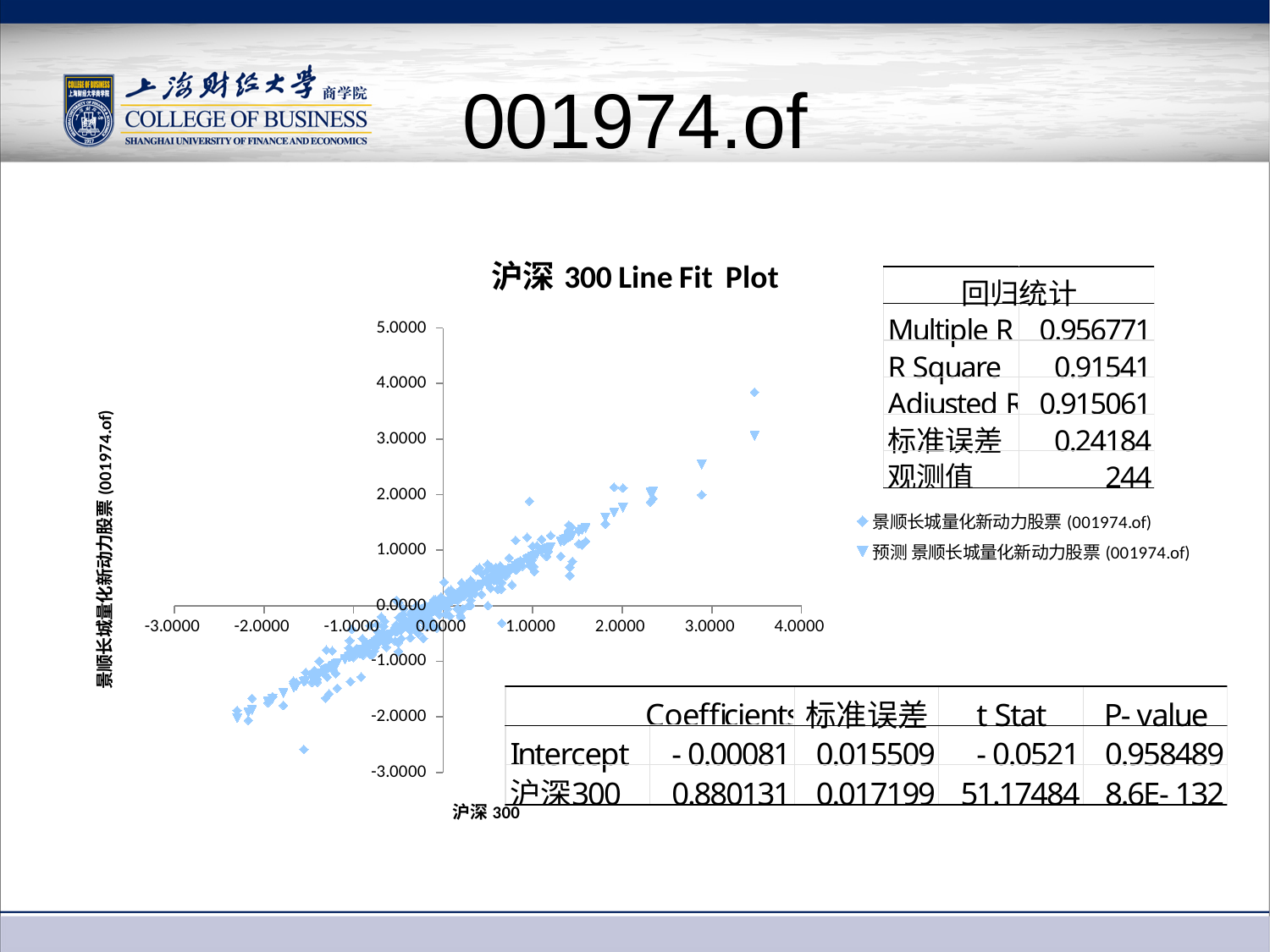
Is the x value of the rightmost plotted point greater or less than 3.0000? greater As the x-axis values increase, do the plotted y values generally rise or fall? Rise How many series does the chart's legend list? 2 Is the y value of the highest plotted point greater or less than 3.0000? greater What is the label of the chart's x axis? 沪深 300 What kind of chart is shown on the slide? Scatter chart What is the title of the chart? 沪深 300 Line Fit Plot Is the y value of the lowest plotted point greater or less than -2.0000? less What is the highest tick value shown on the chart's y axis? 5.0000